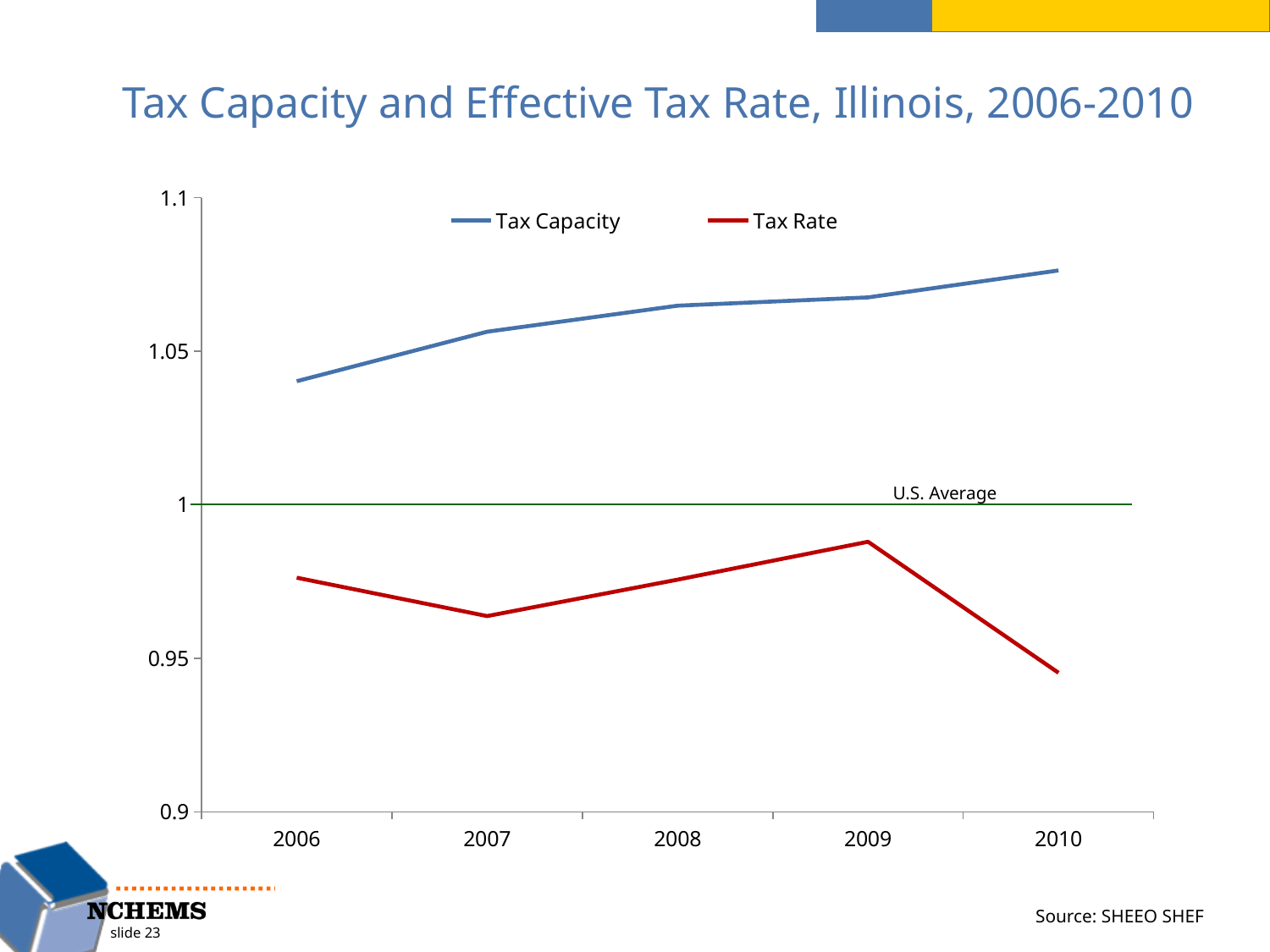
In which year is Tax Rate lowest? 2010 Is the Tax Rate value for 2010 greater or less than 0.95? less In which year is Tax Capacity lowest? 2006 Does the Tax Capacity line rise or fall from 2006 to 2010? Rises At what value is the U.S. Average reference line drawn? 1 In which year is Tax Capacity highest? 2010 How many years are plotted along the x axis? 5 How many series does the legend list? 2 In 2008, which is larger, Tax Capacity or Tax Rate? Tax Capacity In which year is Tax Rate highest? 2009 What kind of chart is shown on the slide? Line chart Is the Tax Capacity value for 2010 greater or less than 1.05? greater